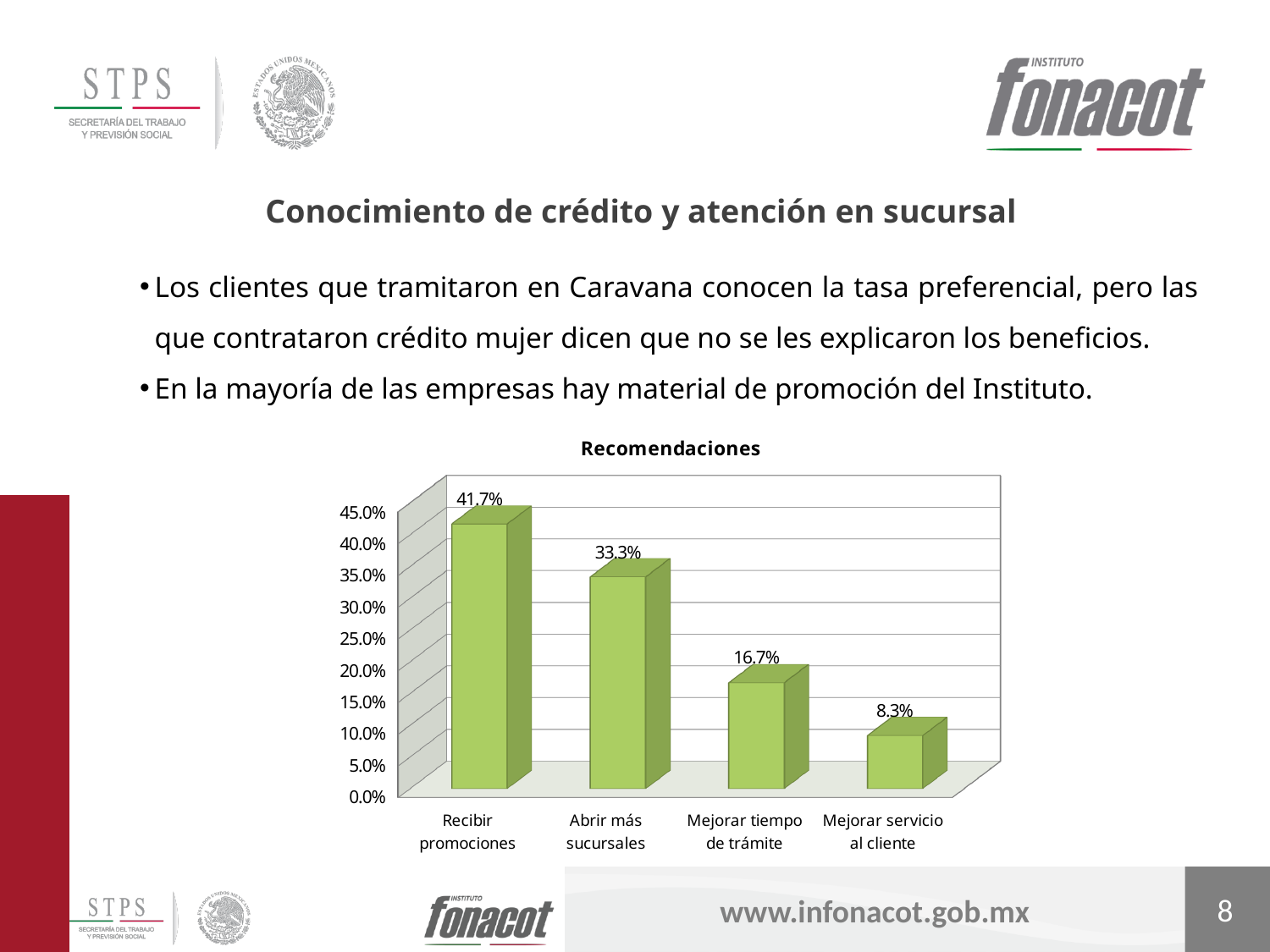
Which is larger, Mejorar tiempo de trámite or Mejorar servicio al cliente? Mejorar tiempo de trámite What is the value for Mejorar servicio al cliente? 8.3% What kind of chart is shown? Bar chart What is the value for Abrir más sucursales? 33.3% What is the title of the chart? Recomendaciones What is the value for Mejorar tiempo de trámite? 16.7% Which category has the lowest value? Mejorar servicio al cliente What is the value for Recibir promociones? 41.7% What is the difference between Recibir promociones and Abrir más sucursales? 8.4% How many categories are shown in the chart? 4 Which category has the highest value? Recibir promociones Is the value for Abrir más sucursales greater or less than 30.0%? greater